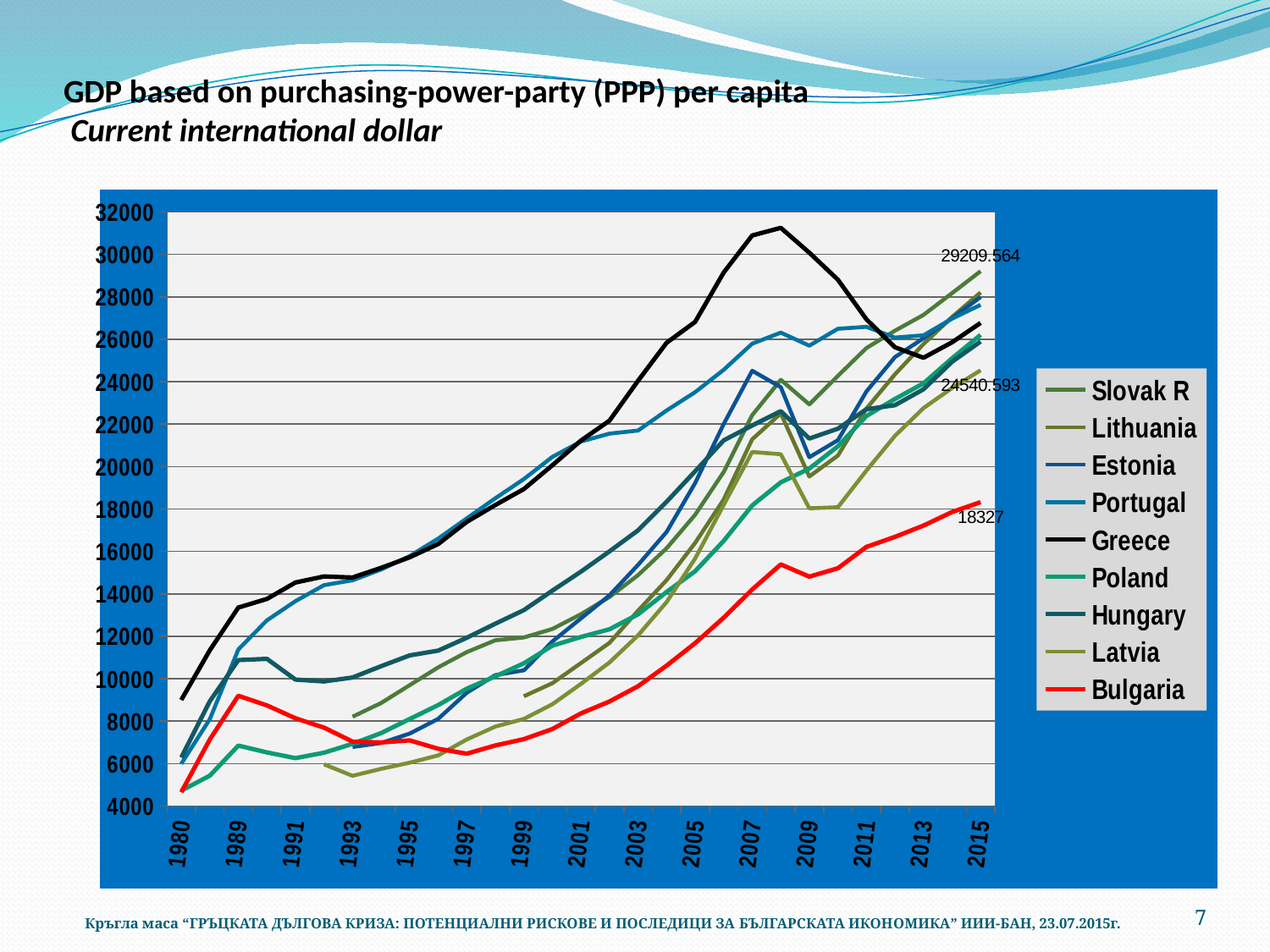
What is the value for Bulgaria in 2015? 18327 What is the value for Slovak R in 2015? 29209.564 What is the value for Latvia in 2015? 24540.593 What kind of chart is shown on the slide? line chart What is the difference between the 2015 values for Slovak R and Bulgaria? 10882.564 Is the peak value for Greece (around 2008) greater or less than 30000? greater How many series does the legend list? 9 Which is larger in 2015, the value for Latvia or the value for Bulgaria? Latvia Does the Bulgaria line rise or fall from 2009 to 2015? rise Which series has the lowest value in 2015? Bulgaria What colour is the Bulgaria line? red Is the value for Bulgaria in 1980 greater or less than 6000? less